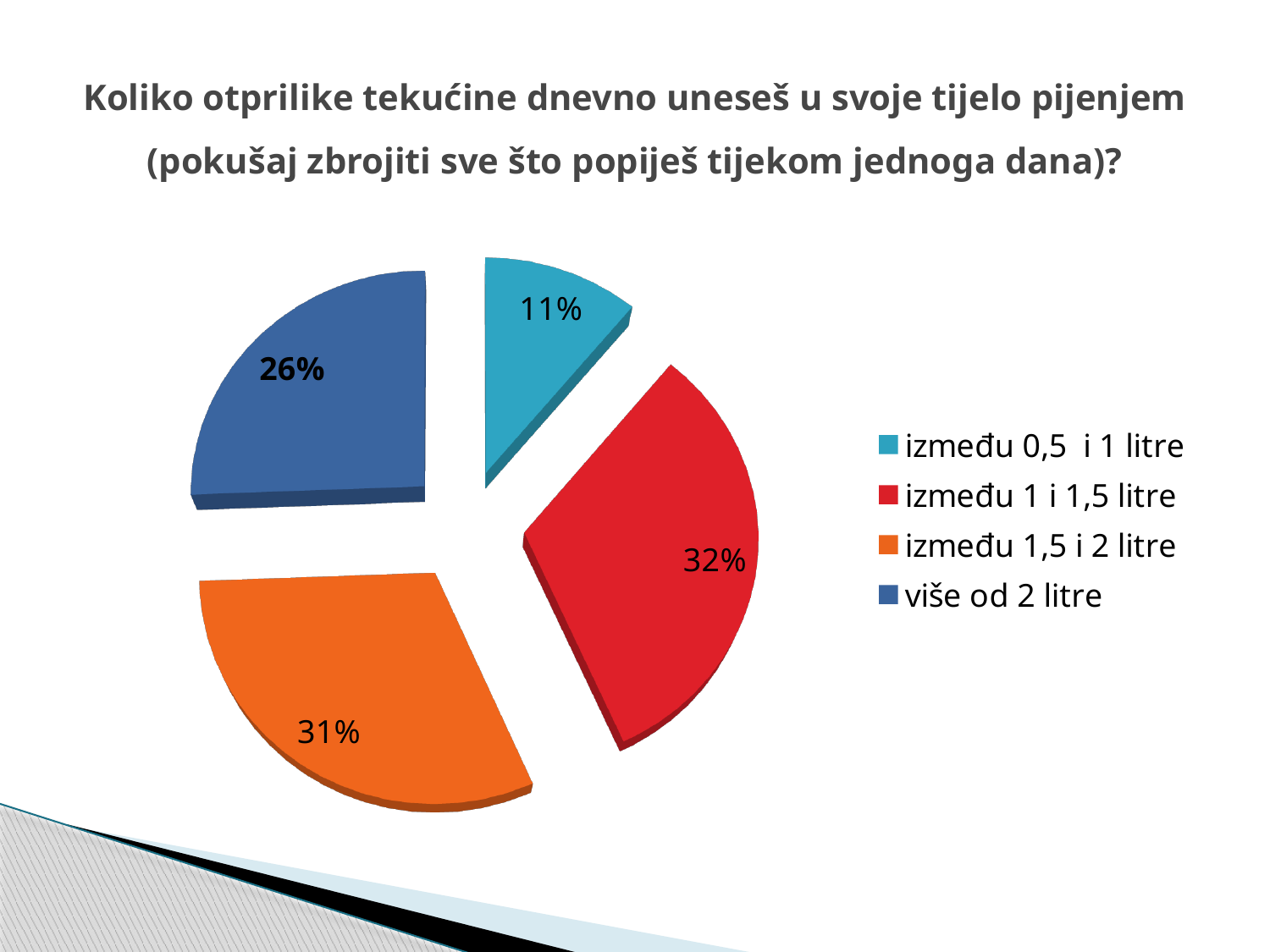
What percentage is shown for 'između 1,5 i 2 litre'? 31% Which category has the smallest slice of the pie? između 0,5 i 1 litre What percentage is shown for 'između 1 i 1,5 litre'? 32% What percentage is shown for 'više od 2 litre'? 26% Which is larger: the slice for 'između 1,5 i 2 litre' or the slice for 'više od 2 litre'? između 1,5 i 2 litre What is the difference in percentage points between 'između 1 i 1,5 litre' and 'više od 2 litre'? 6 Which category has the largest slice of the pie? između 1 i 1,5 litre How many slices does the pie chart have? 4 What kind of chart is shown on the slide? pie chart What share of the pie is labelled for 'između 0,5 i 1 litre'? 11% What colour is the slice for 'više od 2 litre'? blue How many entries does the legend list? 4